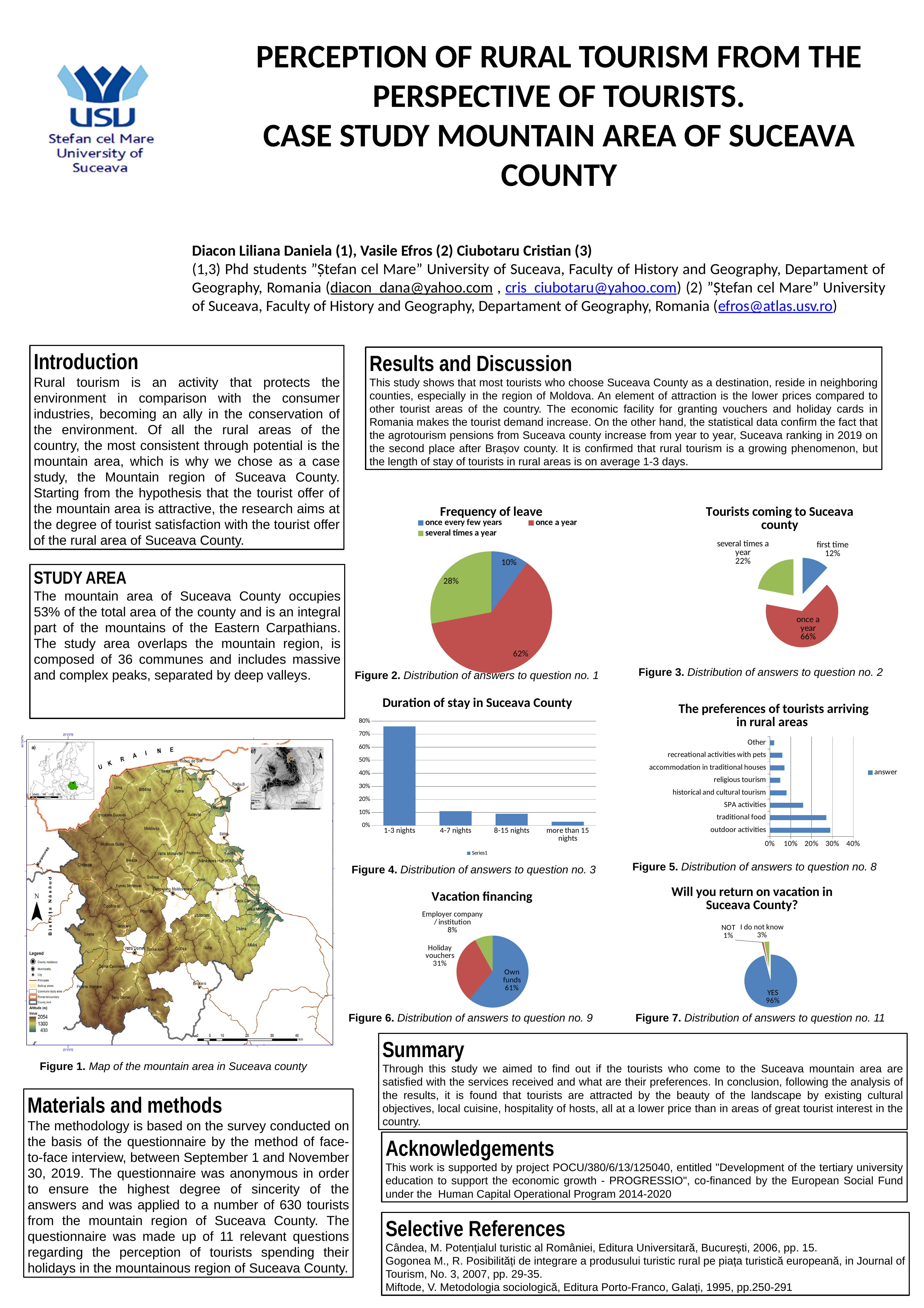
In the "Frequency of leave" pie chart, which category has the smallest share? once every few years What kind of chart is "Duration of stay in Suceava County"? bar chart In the "Tourists coming to Suceava county" pie chart, what is the difference between the "once a year" share and the "several times a year" share? 44% In "The preferences of tourists arriving in rural areas" chart, is the value for "SPA activities" greater or less than 10%? greater In the "Will you return on vacation in Suceava County?" pie chart, what share answered "YES"? 96% How many categories are shown in the "Duration of stay in Suceava County" chart? 4 In the "Tourists coming to Suceava county" pie chart, what share of tourists are coming for the first time? 12% In the "Duration of stay in Suceava County" chart, which category has the highest value? 1-3 nights In the "Vacation financing" pie chart, what share is "Holiday vouchers"? 31% In the "Duration of stay in Suceava County" chart, is the value for "1-3 nights" greater or less than 70%? greater In "The preferences of tourists arriving in rural areas" chart, which category has the lowest value? Other In the "Frequency of leave" pie chart, what share of answers is "once a year"? 62%